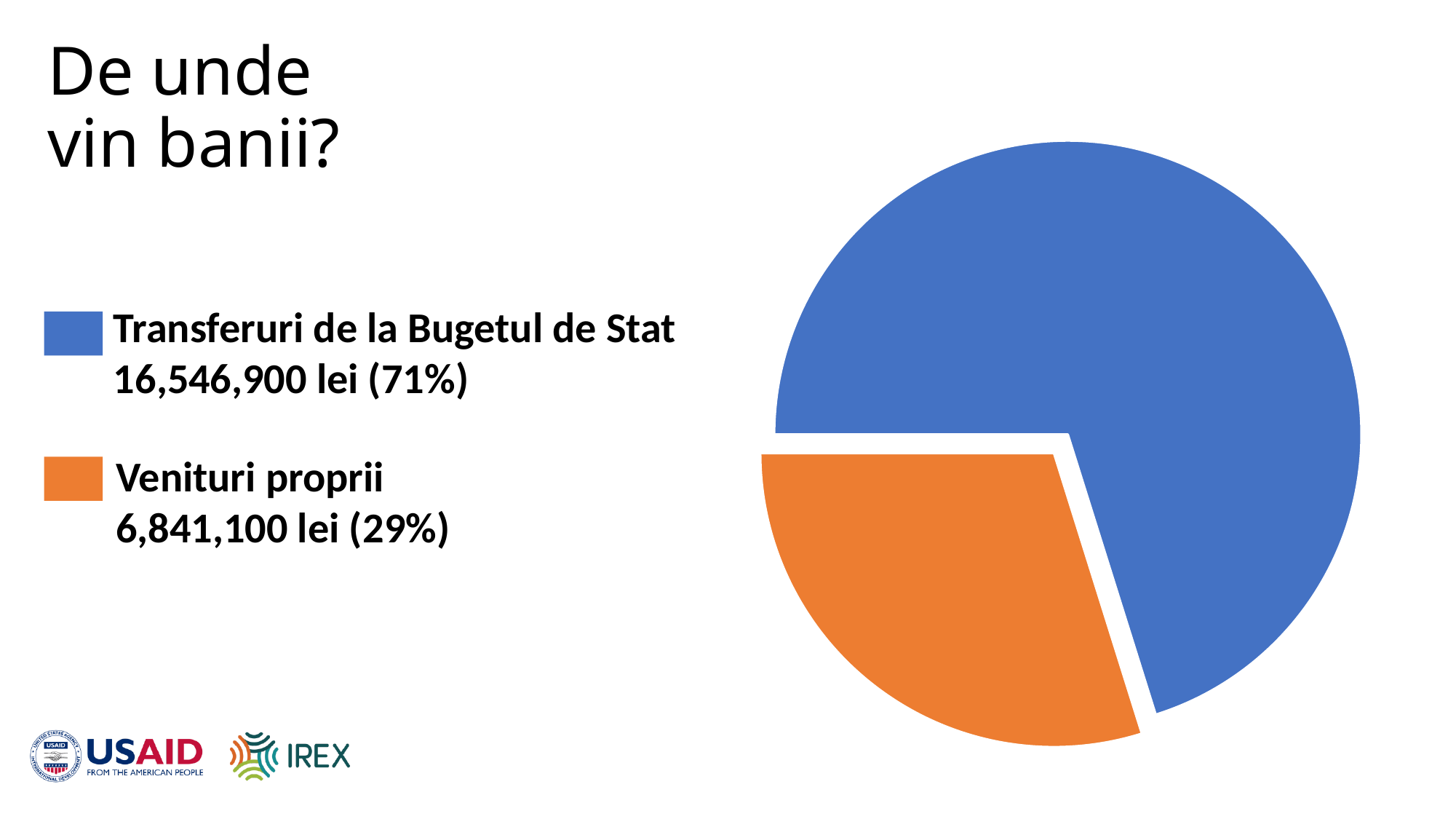
What is the value for Transferuri de la Bugetul de Stat? 16,546,900 lei What share of the pie does Venituri proprii represent? 29% How many slices does the pie chart have? 2 What is the total of the two categories in lei? 23,388,000 lei Which category has the smallest slice of the pie? Venituri proprii Which is larger, Transferuri de la Bugetul de Stat or Venituri proprii? Transferuri de la Bugetul de Stat What colour is the slice for Venituri proprii? orange What share of the pie does Transferuri de la Bugetul de Stat represent? 71% What kind of chart is shown on the slide? pie chart What is the difference in lei between Transferuri de la Bugetul de Stat and Venituri proprii? 9,705,800 lei What is the value for Venituri proprii? 6,841,100 lei Which category has the largest slice of the pie? Transferuri de la Bugetul de Stat